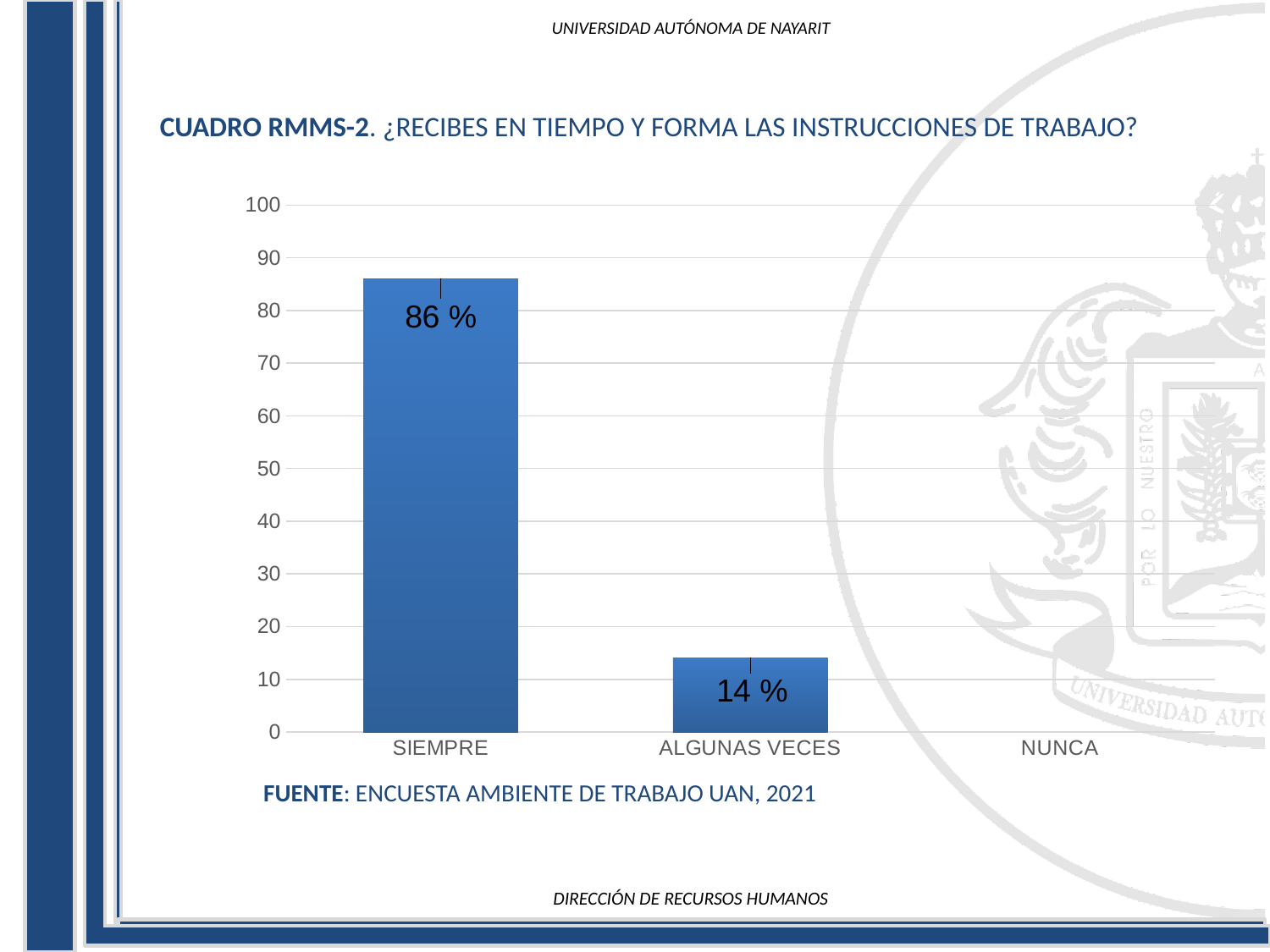
What is the value for SIEMPRE? 86 % What kind of chart is shown on the slide? bar chart Which category has the highest value? SIEMPRE Is the value for SIEMPRE greater or less than 80? greater What is the value for ALGUNAS VECES? 14 % What is the difference between the values for SIEMPRE and ALGUNAS VECES? 72 % What question does the chart title ask? ¿RECIBES EN TIEMPO Y FORMA LAS INSTRUCCIONES DE TRABAJO? Which is larger, the value for SIEMPRE or the value for ALGUNAS VECES? SIEMPRE Is the value for ALGUNAS VECES greater or less than 20? less How many categories are shown on the x axis? 3 What source is cited below the chart? ENCUESTA AMBIENTE DE TRABAJO UAN, 2021